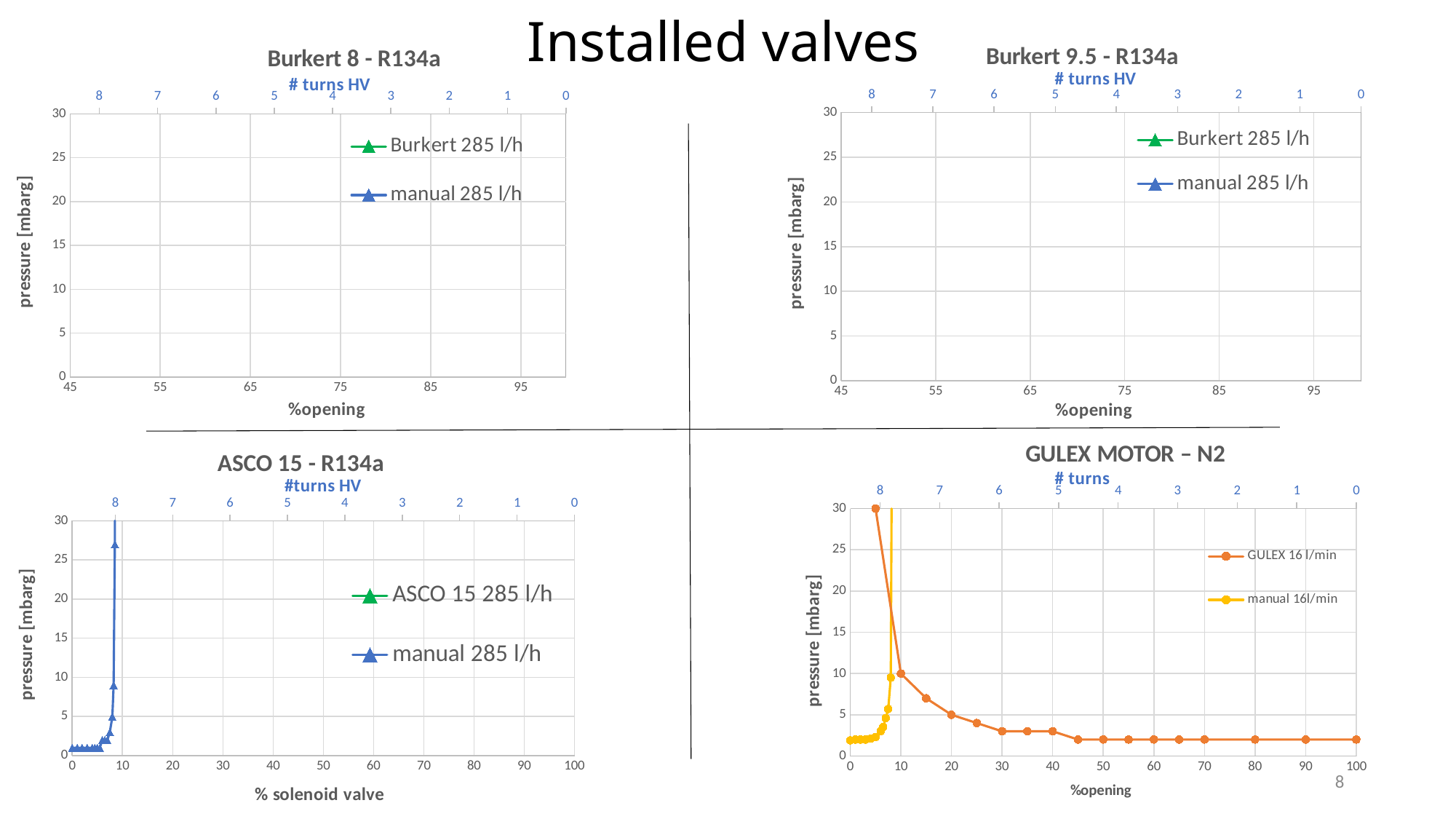
In the ASCO 15 - R134a chart, does the manual 285 l/h pressure rise or fall as % solenoid valve increases toward 8? rise In the GULEX MOTOR – N2 chart, does the GULEX 16 l/min pressure rise or fall as %opening increases? fall In the GULEX MOTOR – N2 chart, is the GULEX 16 l/min pressure larger at 15 %opening or at 40 %opening? 15 %opening How many series does the legend of the GULEX MOTOR – N2 chart list? 2 How many series does the legend of the ASCO 15 - R134a chart list? 2 In the GULEX MOTOR – N2 chart, is the GULEX 16 l/min pressure at 5 %opening greater or less than 25? greater What colour is the manual 16l/min series in the GULEX MOTOR – N2 chart? yellow In the ASCO 15 - R134a chart, is the manual 285 l/h pressure at 2 % solenoid valve greater or less than 5? less In the GULEX MOTOR – N2 chart, is the GULEX 16 l/min pressure at 100 %opening greater or less than 5? less What kind of chart is the GULEX MOTOR – N2 chart? line chart What is the label of the vertical axis on the GULEX MOTOR – N2 chart? pressure [mbarg]